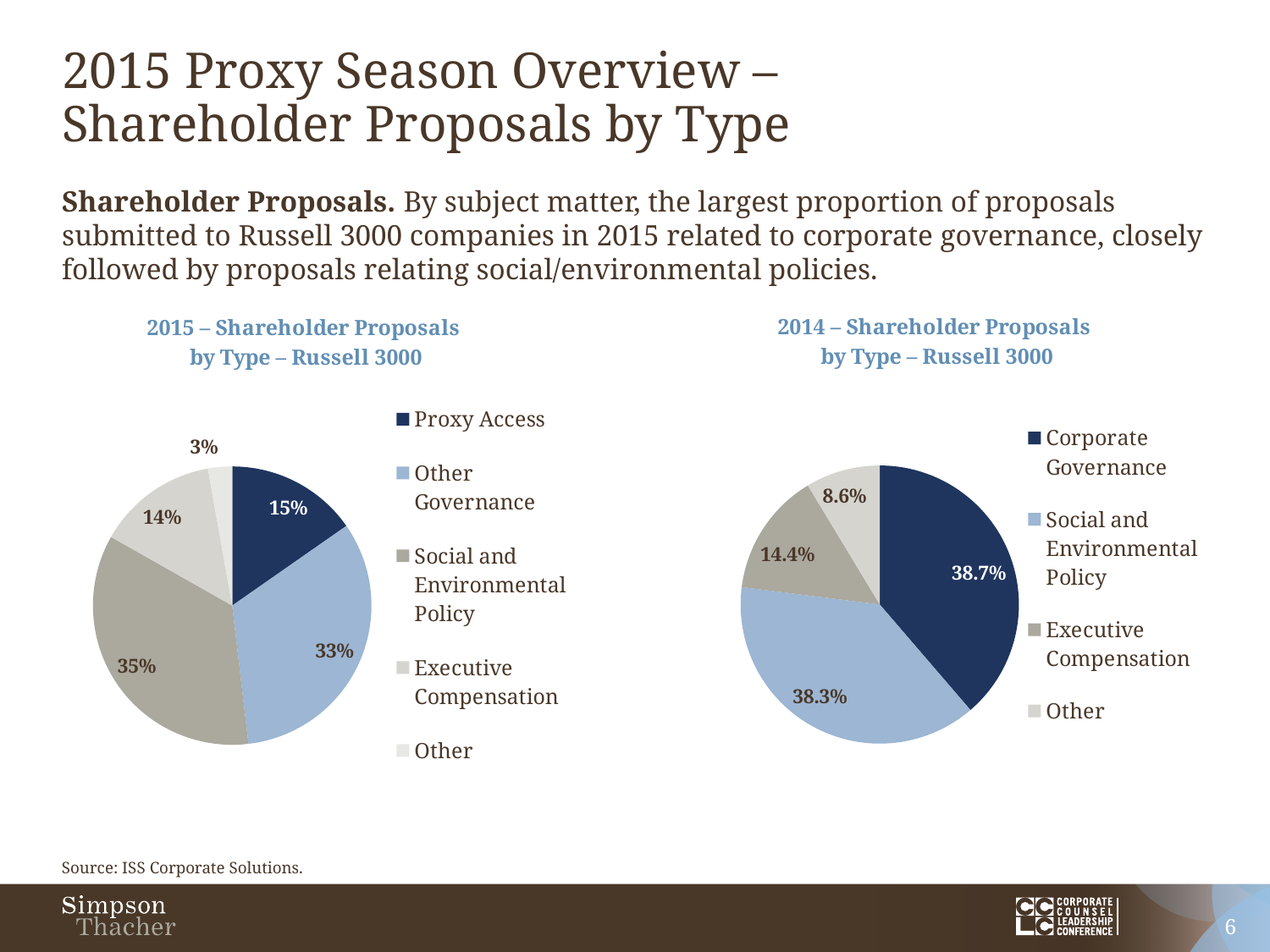
What type of chart is used for the 2015 – Shareholder Proposals by Type – Russell 3000 chart? Pie chart In the 2014 – Shareholder Proposals by Type – Russell 3000 chart, which category has the smallest slice? Other In the 2015 – Shareholder Proposals by Type – Russell 3000 chart, what is the difference in percentage points between Other Governance and Executive Compensation? 19 percentage points In the 2015 – Shareholder Proposals by Type – Russell 3000 chart, what share of proposals related to Social and Environmental Policy? 35% In the 2015 – Shareholder Proposals by Type – Russell 3000 chart, which category has the smallest slice? Other In the 2015 – Shareholder Proposals by Type – Russell 3000 chart, which category has the largest slice? Social and Environmental Policy In the 2014 – Shareholder Proposals by Type – Russell 3000 chart, how many categories does the legend list? 4 In the 2014 – Shareholder Proposals by Type – Russell 3000 chart, what percentage is shown for Executive Compensation? 14.4% In the 2015 – Shareholder Proposals by Type – Russell 3000 chart, how many categories does the legend list? 5 In the 2014 – Shareholder Proposals by Type – Russell 3000 chart, what share of proposals related to Corporate Governance? 38.7% In the 2015 – Shareholder Proposals by Type – Russell 3000 chart, what percentage is shown for Proxy Access? 15% In the 2014 – Shareholder Proposals by Type – Russell 3000 chart, what is the difference in percentage points between Executive Compensation and Other? 5.8 percentage points